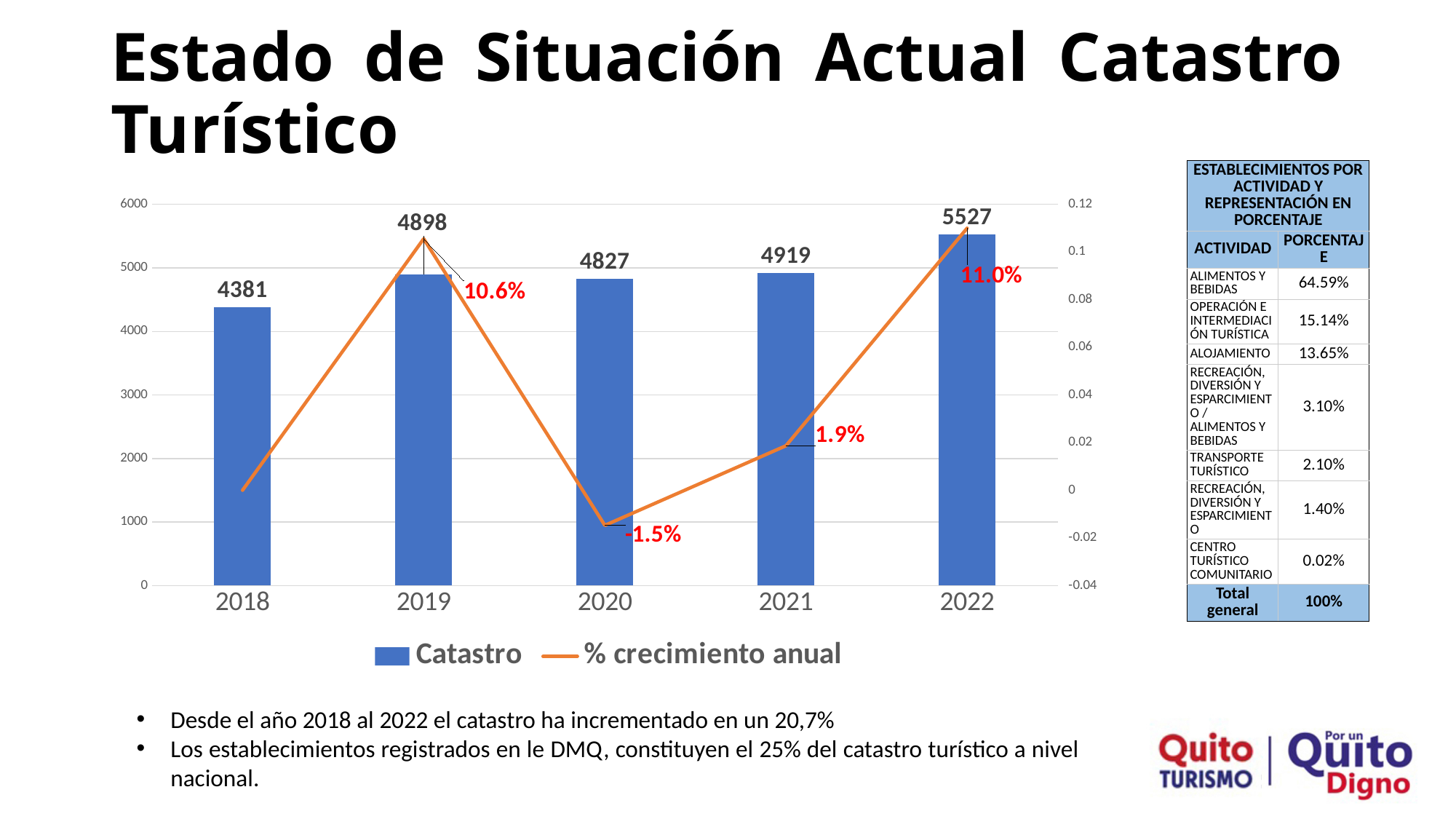
What is the Catastro value for 2019? 4898 What is the Catastro value for 2022? 5527 Is the Catastro value for 2018 greater or less than 4000? greater What is the difference between the Catastro values for 2022 and 2018? 1146 Which year has the lowest Catastro value? 2018 What is the % crecimiento anual value shown for 2020? -1.5% Which year has a larger Catastro value, 2019 or 2021? 2021 How many series does the chart legend list? 2 How many years are shown on the x axis of the chart? 5 Which year has the lowest % crecimiento anual value among the labelled points? 2020 What is the % crecimiento anual value shown for 2021? 1.9% Which year has the highest Catastro value? 2022